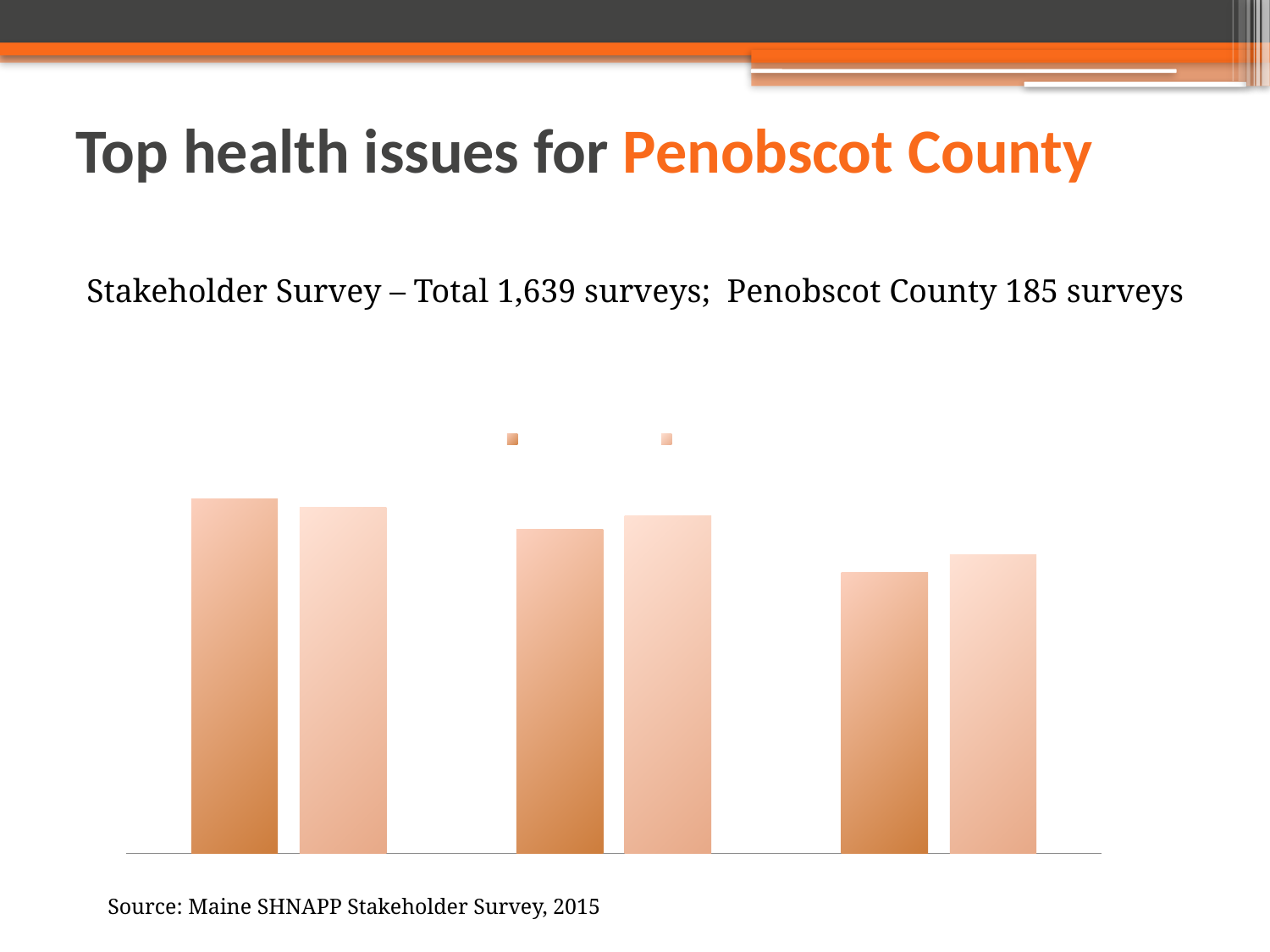
What kind of chart is shown on the slide? bar chart In the leftmost group of bars, is the darker orange bar or the lighter orange bar taller? the darker orange bar How many series does the chart's legend list? 2 In the rightmost group of bars, is the darker orange bar or the lighter orange bar taller? the lighter orange bar What source is cited below the chart? Maine SHNAPP Stakeholder Survey, 2015 Does the chart display numeric data labels on its bars? No Do the lighter orange bars rise or fall from left to right across the chart? fall Which group of bars contains the shortest bar on the chart? the rightmost group In the middle group of bars, is the darker orange bar or the lighter orange bar taller? the lighter orange bar Do the darker orange bars rise or fall from left to right across the chart? fall Which group of bars contains the tallest bar on the chart? the leftmost group How many groups of bars (categories) does the chart show? 3